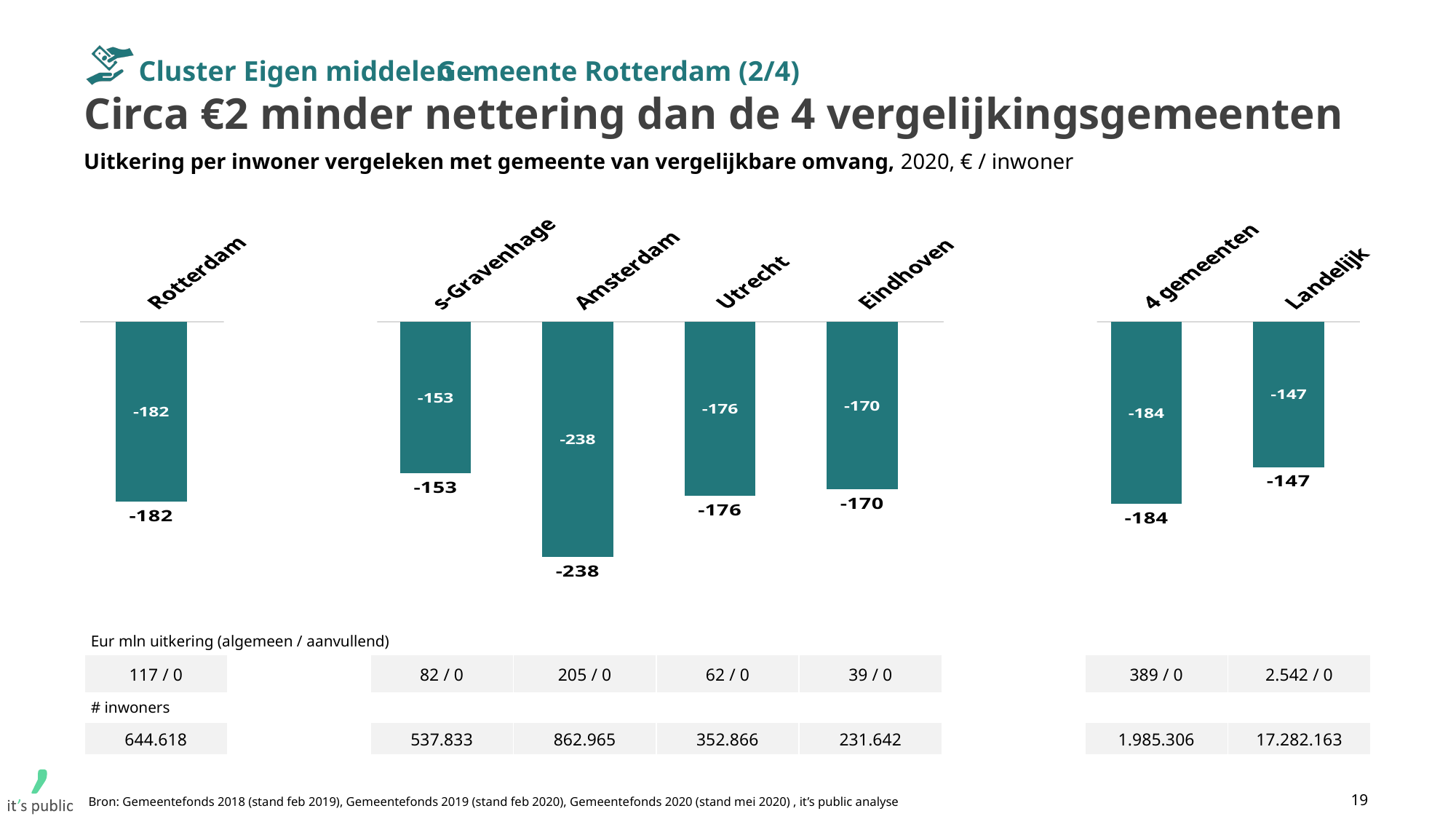
How many categories are shown in the middle chart? 4 In the middle chart, what is the value for Eindhoven? -170 What is the difference between the value for Amsterdam in the middle chart and the value for s-Gravenhage in the middle chart? 85 What is the unit stated in the chart subtitle? € / inwoner In the middle chart, which category has the lowest (most negative) value? Amsterdam In the middle chart, what is the value for Amsterdam? -238 Which is larger, the value for 4 gemeenten in the right chart or the value for Landelijk in the right chart? Landelijk What kind of chart is the middle chart? Bar chart In the middle chart, which category has the highest (least negative) value? s-Gravenhage In the middle chart, what is the value for Utrecht? -176 In the left chart, what is the value for Rotterdam? -182 In the right chart, what is the value for Landelijk? -147